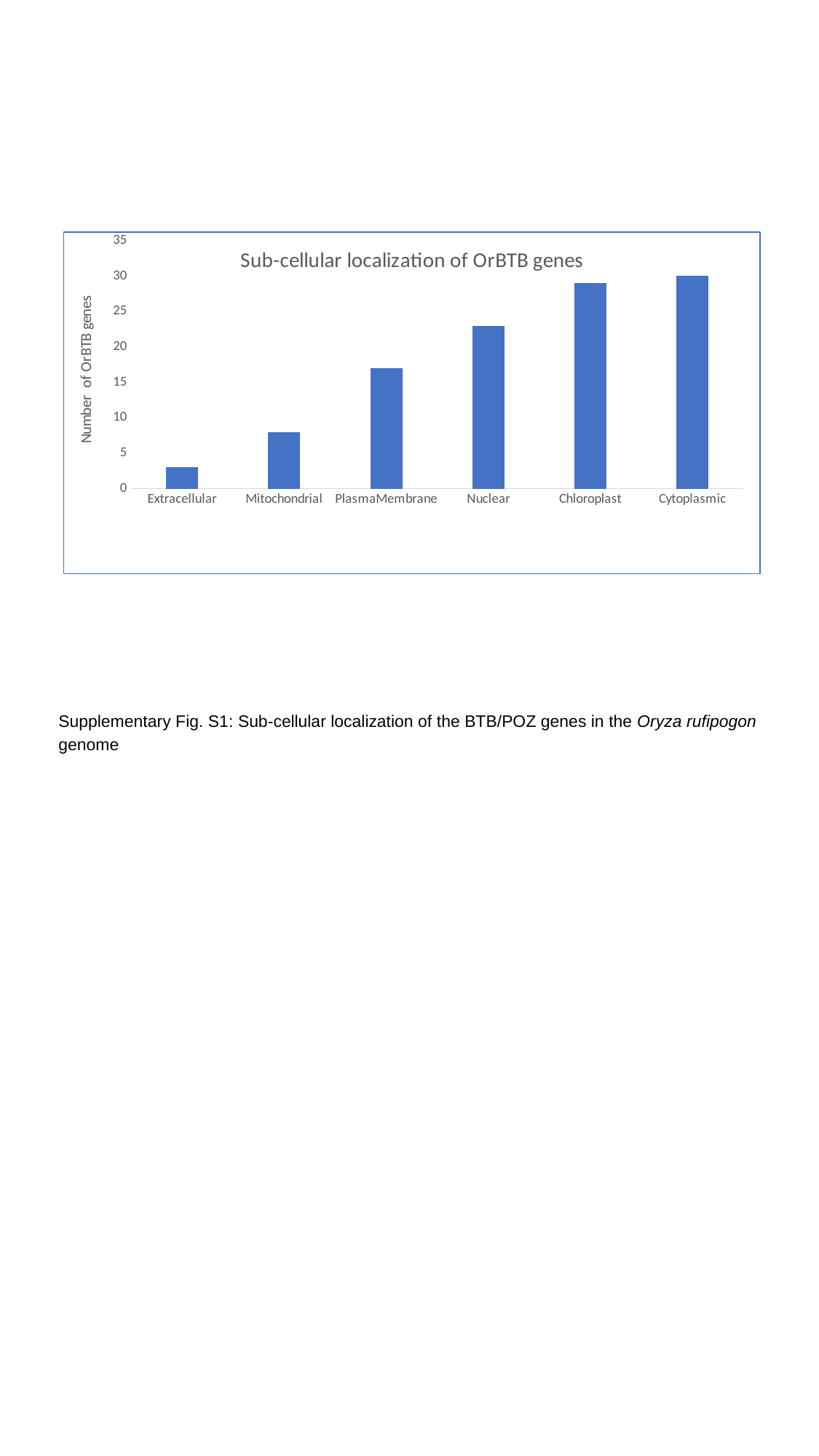
Is the value for Nuclear greater or less than 20? greater Is the value for Extracellular greater or less than 5? less Is the value for PlasmaMembrane greater or less than 15? greater Which has more OrBTB genes, Nuclear or Mitochondrial? Nuclear What is the label of the vertical axis? Number of OrBTB genes Do the bar values rise or fall from left to right along the x axis? rise What is the title of the chart? Sub-cellular localization of OrBTB genes How many sub-cellular localization categories are shown on the x axis? 6 What kind of chart is shown on the slide? bar chart Which category has the lowest number of OrBTB genes? Extracellular